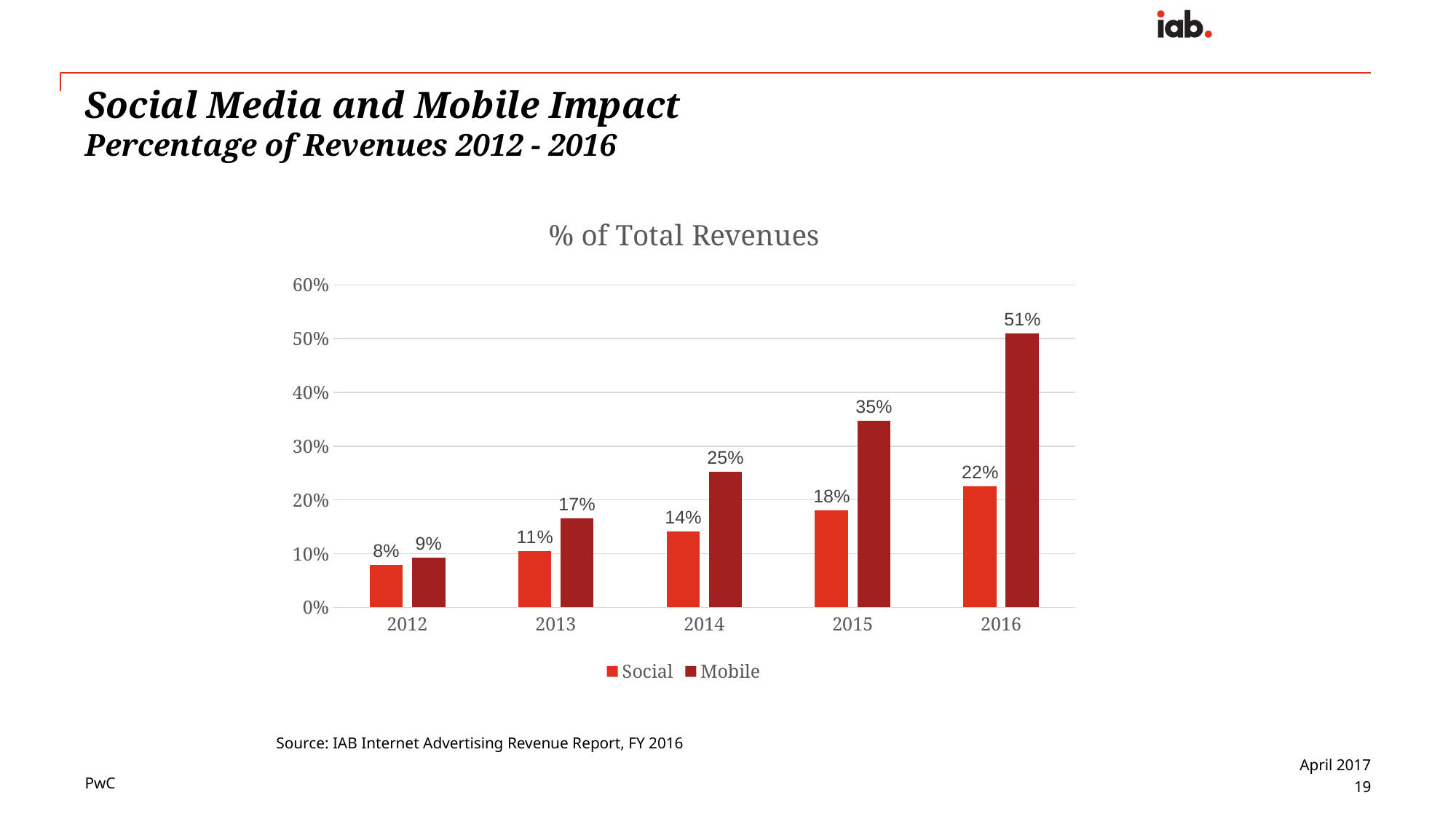
How many years are shown on the x axis? 5 Which year has the lowest Social value? 2012 What is the Social value for 2012? 8% What is the Social value for 2014? 14% Is the Mobile value for 2015 greater or less than 30%? greater What is the Mobile value for 2016? 51% How many series does the legend list? 2 Do the Social values rise or fall from 2012 to 2016? Rise Which year has the highest Mobile value? 2016 What kind of chart is shown? Bar chart Which is larger in 2015, Social or Mobile? Mobile What is the difference between the Mobile and Social values in 2016? 29%